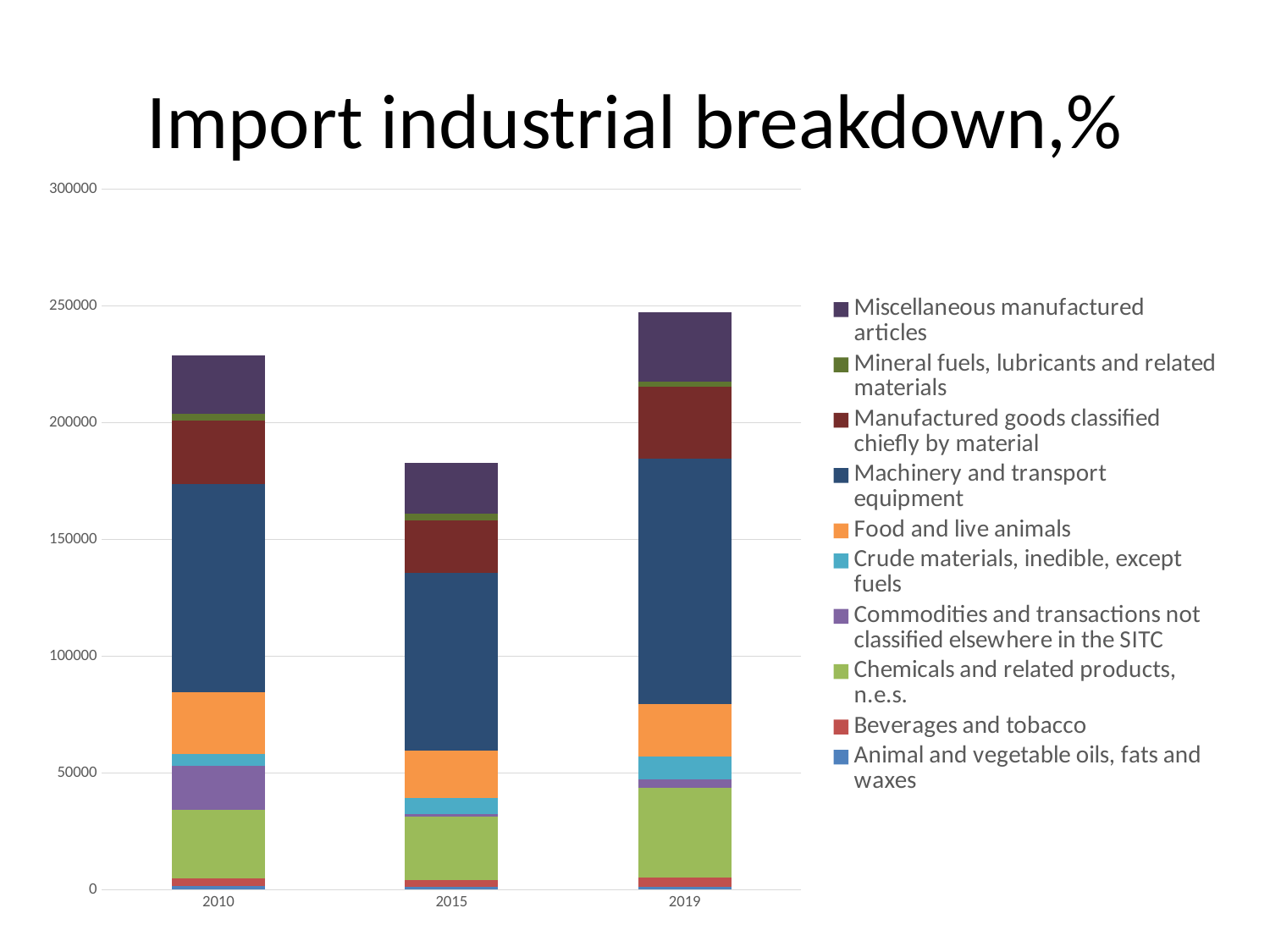
Which series forms the largest segment in every bar? Machinery and transport equipment Which bar is taller overall, 2010 or 2015? 2010 Is the total of the 2015 bar greater or less than 200000? less What kind of chart is shown on the slide? Stacked bar chart Which year has the shortest stacked bar overall? 2015 Which year has the tallest stacked bar overall? 2019 Is the total of the 2010 bar greater or less than 250000? less How many years (categories) are shown on the x axis? 3 What is the title of the chart? Import industrial breakdown,% Which series is shown in orange in the legend? Food and live animals Is the total of the 2019 bar greater or less than 200000? greater How many series does the legend list? 10